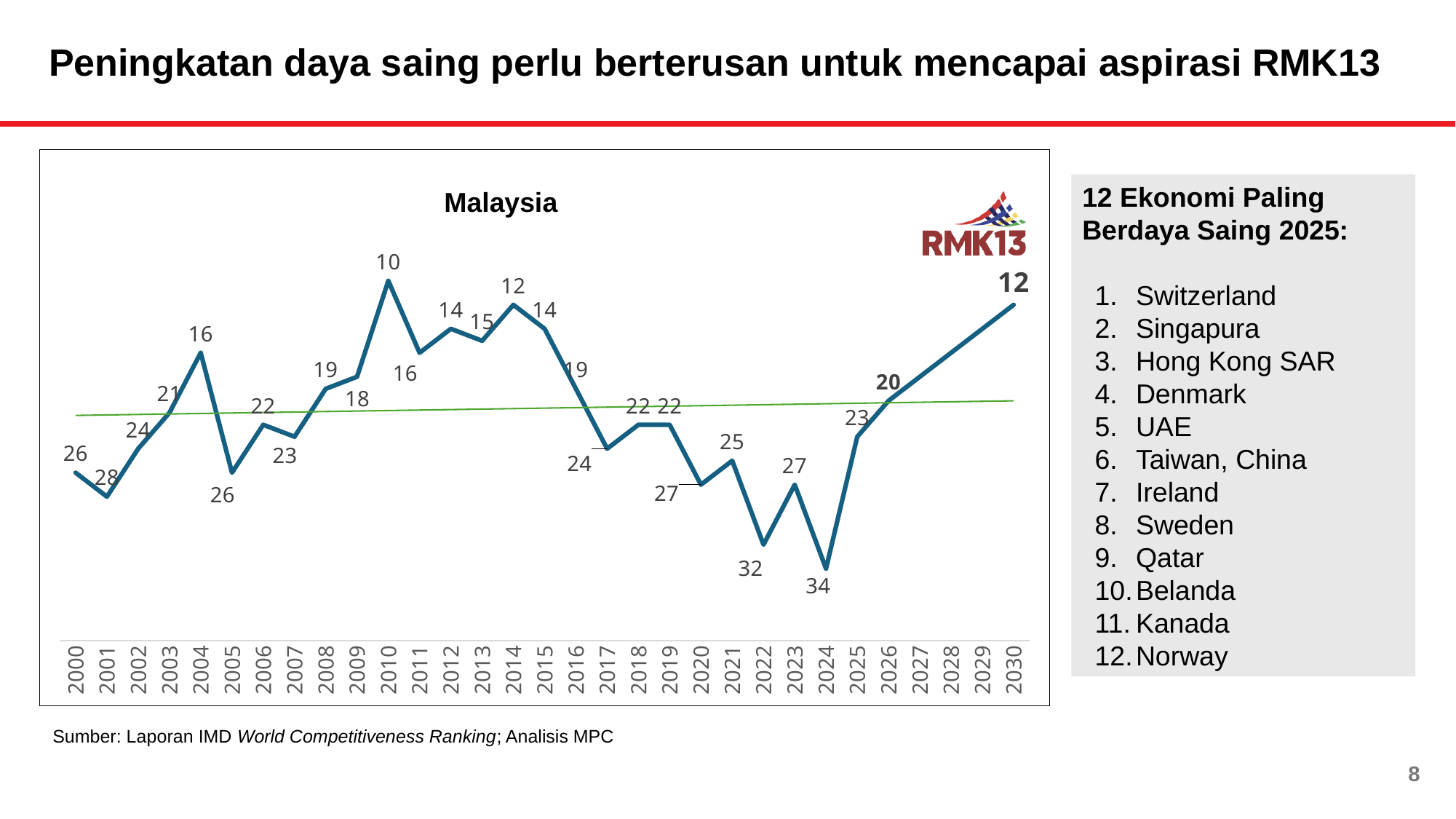
What is the value for 2024? 34 Which year has the smallest number plotted? 2010 How many years are shown on the x axis? 31 What kind of chart is shown on the slide? line chart What is the value for 2026? 20 What is the value for 2010? 10 What is the title of the chart? Malaysia Which year has the larger value, 2022 or 2023? 2022 Which year has the largest number plotted? 2024 What is the difference between the values for 2024 and 2030? 22 What is the value for 2030? 12 Do the plotted values rise or fall from 2024 to 2030? fall